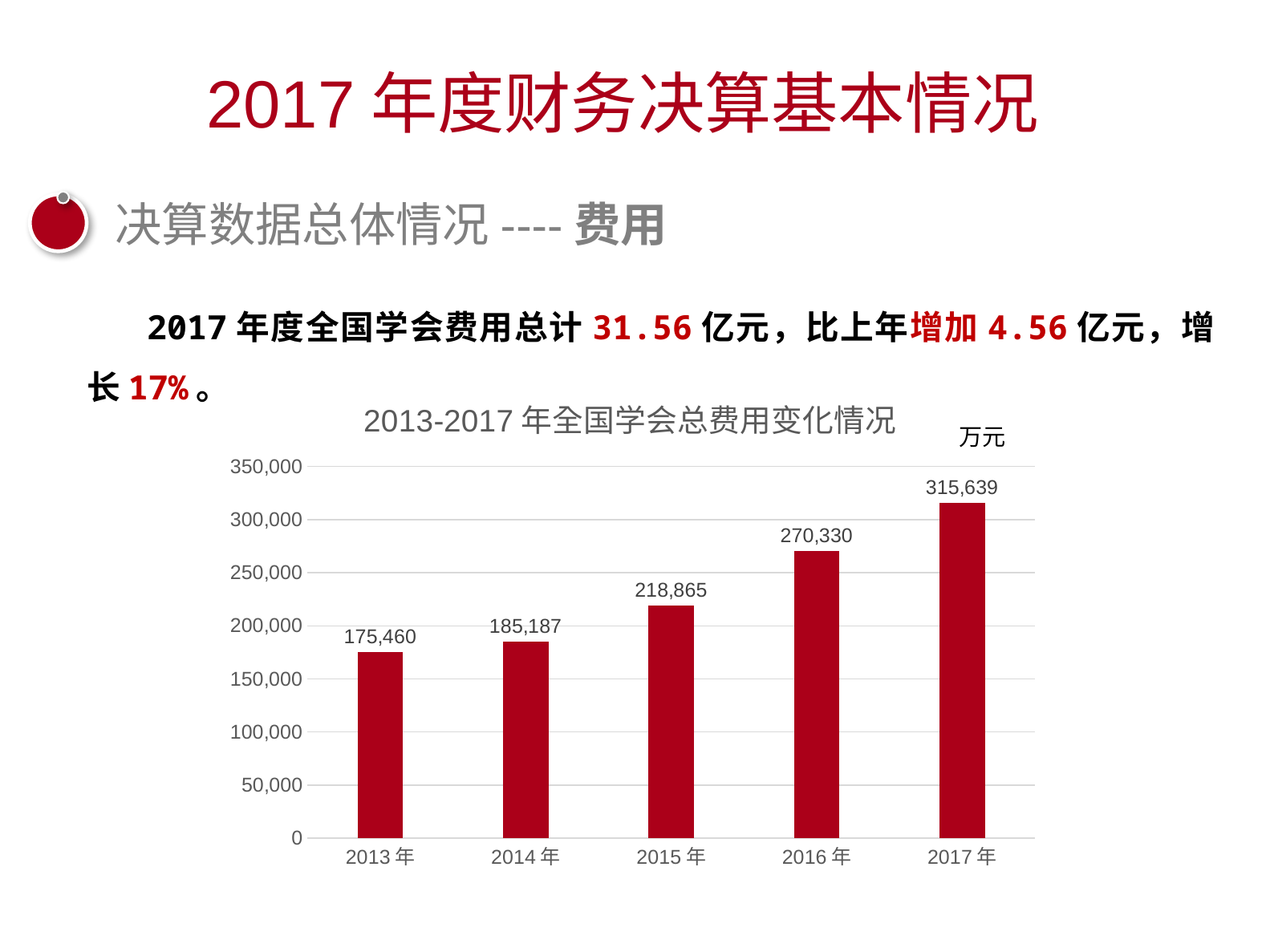
What kind of chart is this? bar chart What is the value for 2017年? 315,639 What is the difference between the values for 2014年 and 2013年? 9,727 Is the value for 2016年 greater or less than 250,000? greater Which year has the highest value? 2017年 Which is larger, the value for 2015年 or the value for 2016年? 2016年 How many years are shown on the x axis? 5 What is the difference between the values for 2017年 and 2016年? 45,309 What is the value for 2015年? 218,865 What is the value for 2013年? 175,460 Which year has the lowest value? 2013年 Do the values rise or fall from 2013年 to 2017年? rise